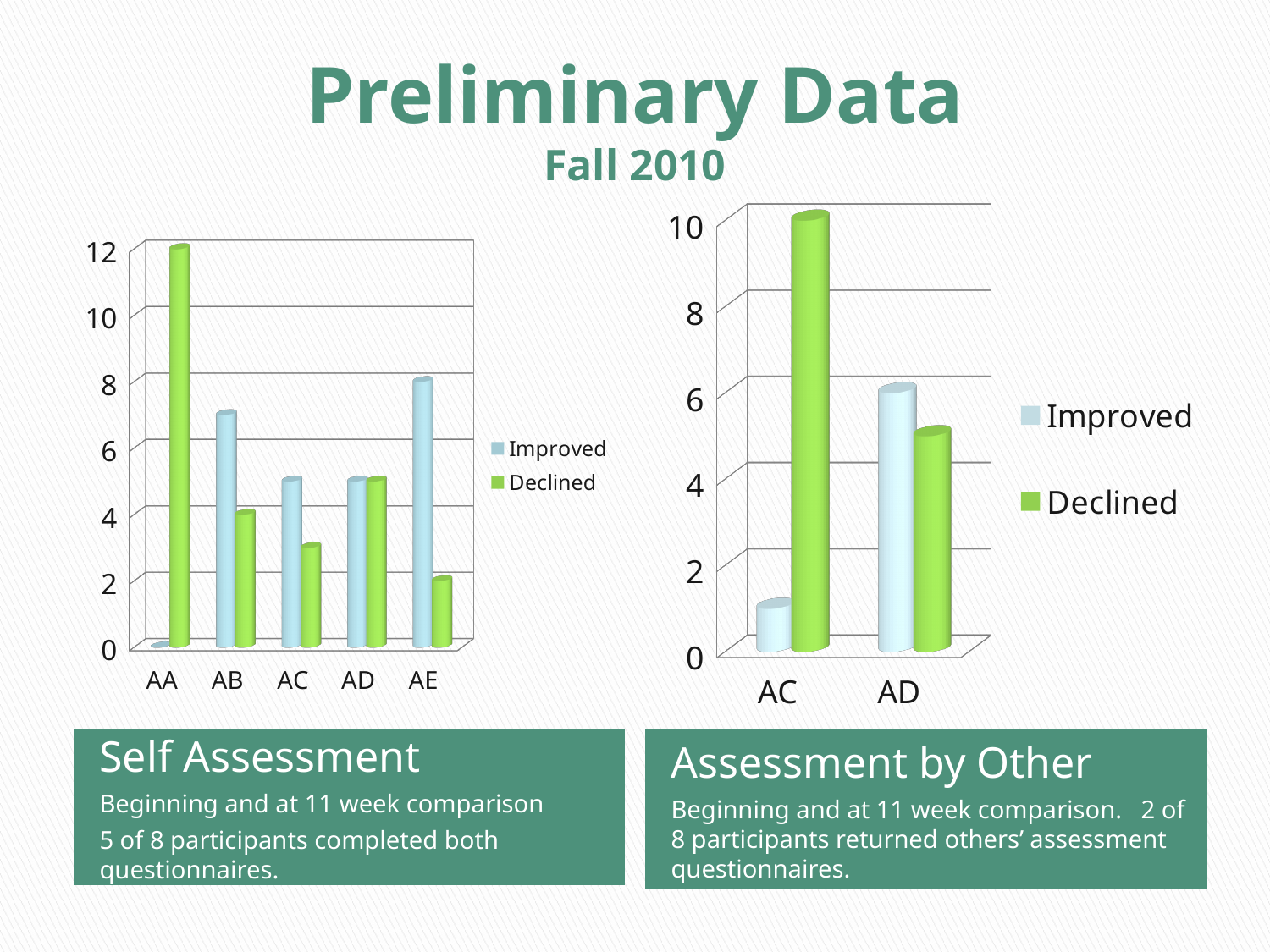
In the left chart (Self Assessment), which category has the highest Declined value? AA What kind of chart is the left chart (Self Assessment)? bar chart In the left chart (Self Assessment), which category has the lowest Improved value? AA How many series does the legend of the right chart (Assessment by Other) list? 2 In the right chart (Assessment by Other), is the Improved value for AC greater or less than 2? less In the right chart (Assessment by Other), which category has the highest Declined value? AC In the right chart (Assessment by Other), which is larger for AD, Improved or Declined? Improved In the left chart (Self Assessment), which category has the highest Improved value? AE In the left chart (Self Assessment), which is larger for AE, Improved or Declined? Improved In the left chart (Self Assessment), is the Declined value for AA greater or less than 10? greater How many categories are shown on the x axis of the left chart (Self Assessment)? 5 In the left chart (Self Assessment), is the Improved value for AB greater or less than 6? greater